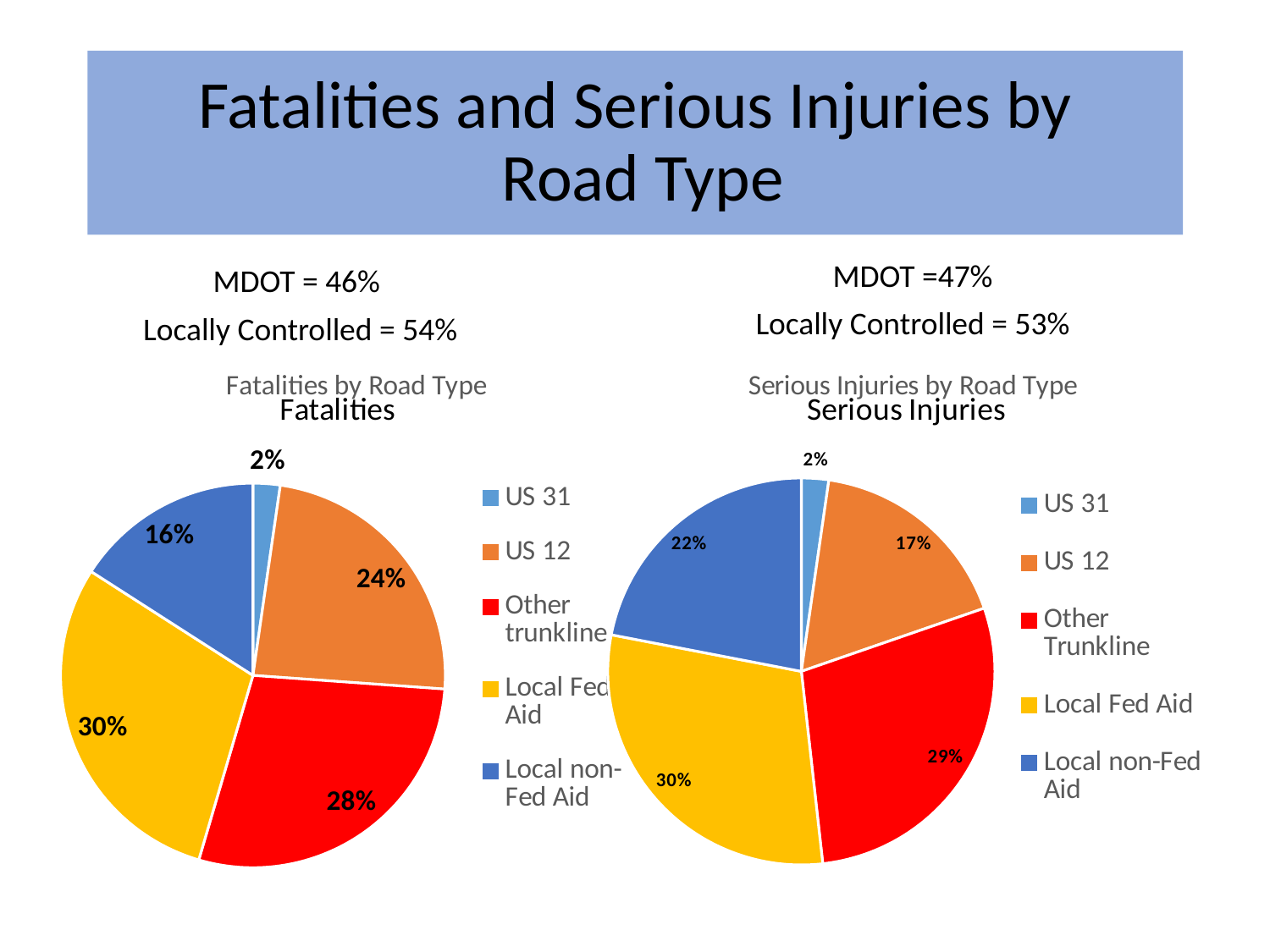
In the Serious Injuries by Road Type pie chart on the right, which is larger: US 12 or Local non-Fed Aid? Local non-Fed Aid In the Fatalities by Road Type pie chart on the left, what share is Local Fed Aid? 30% How many categories does the legend of the Fatalities by Road Type pie chart on the left list? 5 In the Serious Injuries by Road Type pie chart on the right, what share is US 31? 2% In the Fatalities by Road Type pie chart on the left, what is the difference between the Local Fed Aid share and the Local non-Fed Aid share? 14% In the Fatalities by Road Type pie chart on the left, what colour is the Other trunkline slice? Red In the Serious Injuries by Road Type pie chart on the right, what share is Local non-Fed Aid? 22% In the Serious Injuries by Road Type pie chart on the right, what share is Other Trunkline? 29% What type of chart is the Serious Injuries by Road Type chart on the right? Pie chart In the Fatalities by Road Type pie chart on the left, what share is US 12? 24% In the Serious Injuries by Road Type pie chart on the right, which category has the largest slice? Local Fed Aid In the Fatalities by Road Type pie chart on the left, which category has the smallest slice? US 31